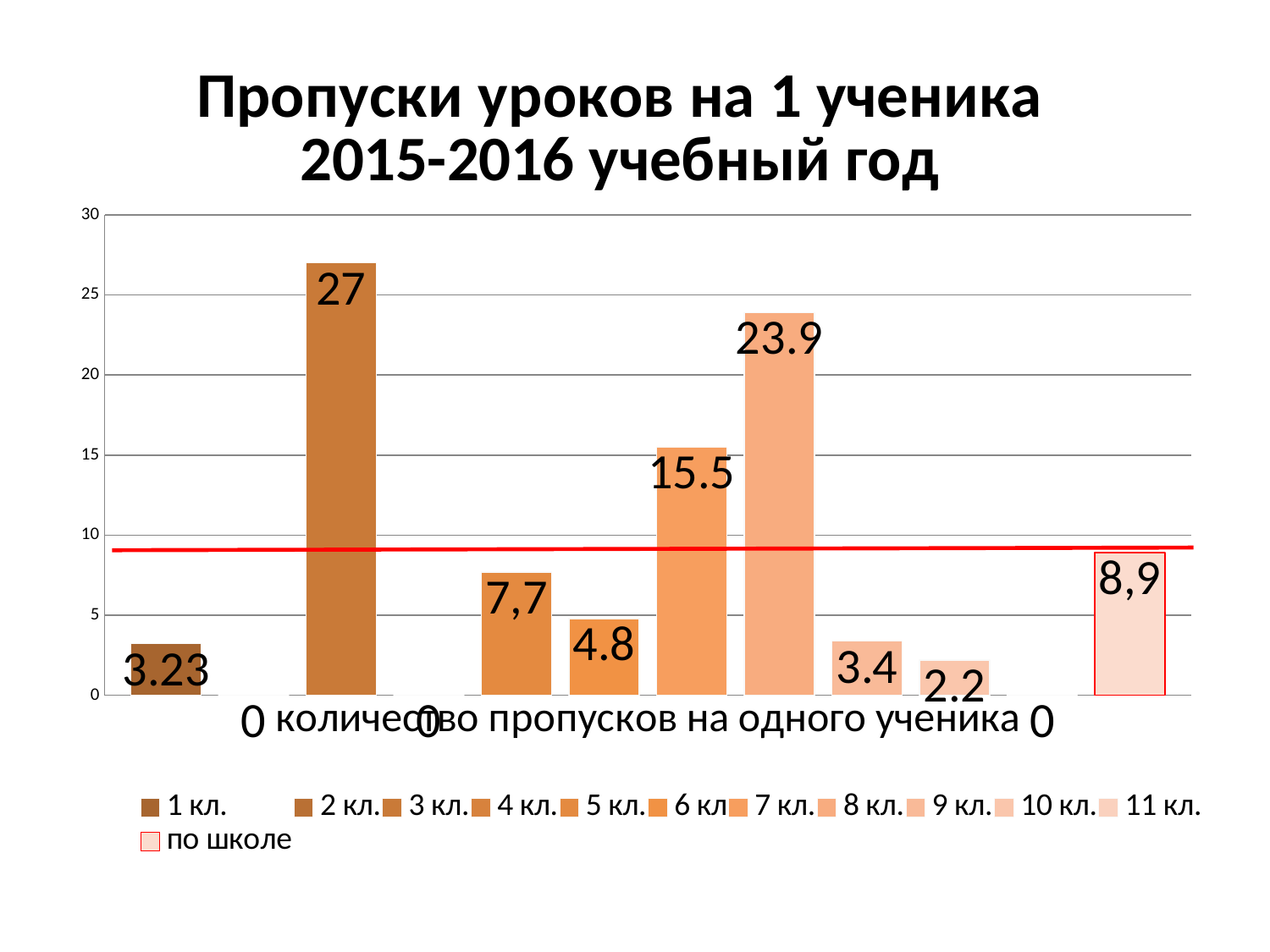
How many series does the legend list? 12 Which series has the highest value? 3 кл. What is the value for 7 кл.? 15.5 What is the value for 8 кл.? 23.9 What is the value for по школе? 8,9 What type of chart is shown on the slide? bar chart What is the value for 1 кл.? 3.23 What is the difference between the values for 3 кл. and 8 кл.? 3.1 Is the value for 8 кл. greater or less than 20? greater What is the title of the chart? Пропуски уроков на 1 ученика 2015-2016 учебный год Which is larger, the value for 7 кл. or the value for 6 кл.? 7 кл. What is the value for 3 кл.? 27